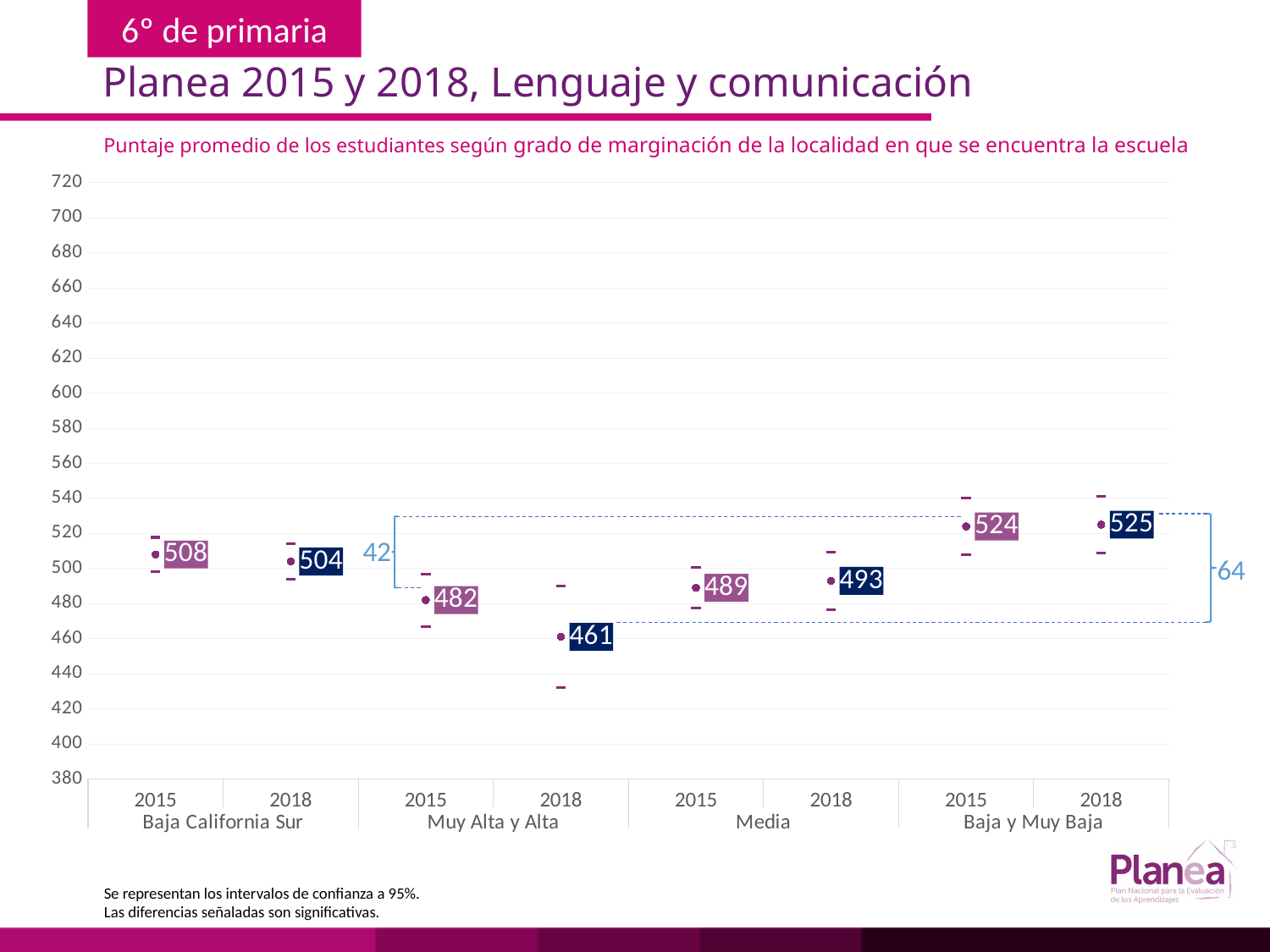
Which group and year has the lowest average score? Muy Alta y Alta, 2018 Which group and year has the highest average score? Baja y Muy Baja, 2018 What is the difference between the Baja y Muy Baja and Muy Alta y Alta scores in 2018? 64 What is the average score for the Media group in 2018? 493 What is the difference between the 2015 and 2018 scores for the Muy Alta y Alta group? 21 Is the 2018 score for Baja California Sur greater or less than 500? greater What is the average score for the Baja y Muy Baja group in 2015? 524 What is the subtitle of the chart? Puntaje promedio de los estudiantes según grado de marginación de la localidad en que se encuentra la escuela Which is larger, the Media score in 2015 or in 2018? 2018 How many marginación groups are shown on the x axis? 4 What is the average score for Baja California Sur in 2015? 508 What is the average score for the Muy Alta y Alta marginación group in 2018? 461